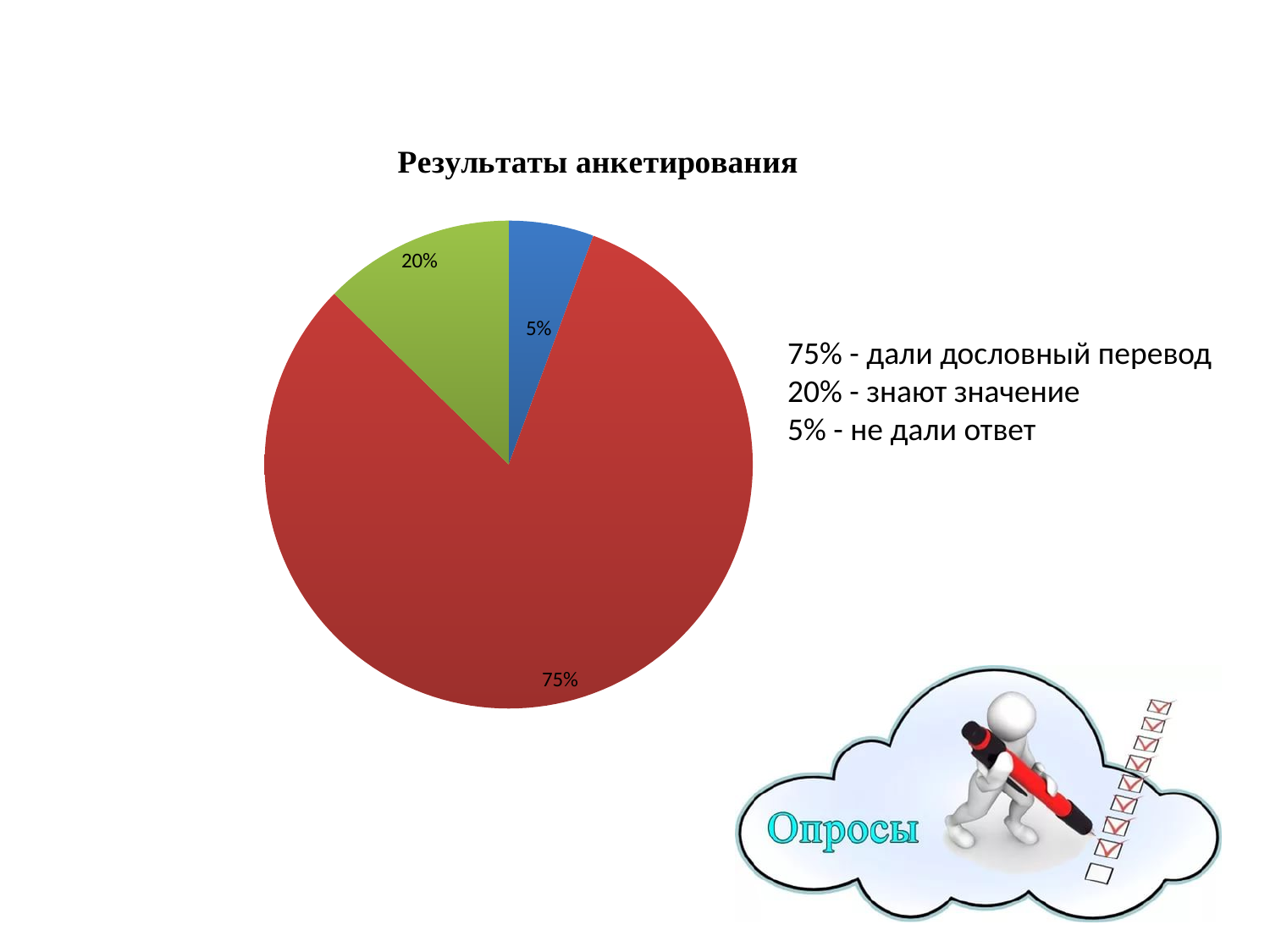
What share of the pie is labelled for respondents who gave a literal translation (дали дословный перевод)? 75% Which is larger: the slice for 'знают значение' or the slice for 'не дали ответ'? знают значение What is the title of the chart? Результаты анкетирования What kind of chart is shown on the slide? pie chart Which category has the largest slice of the pie? дали дословный перевод What is the difference in percentage points between the largest slice and the 20% slice? 55 What share of the pie corresponds to those who know the meaning (знают значение)? 20% Which category has the smallest slice of the pie? не дали ответ What is the difference in percentage points between the 20% slice and the 5% slice? 15 What share of the pie corresponds to those who did not answer (не дали ответ)? 5% How many slices does the pie chart have? 3 What colour is the largest slice of the pie? red